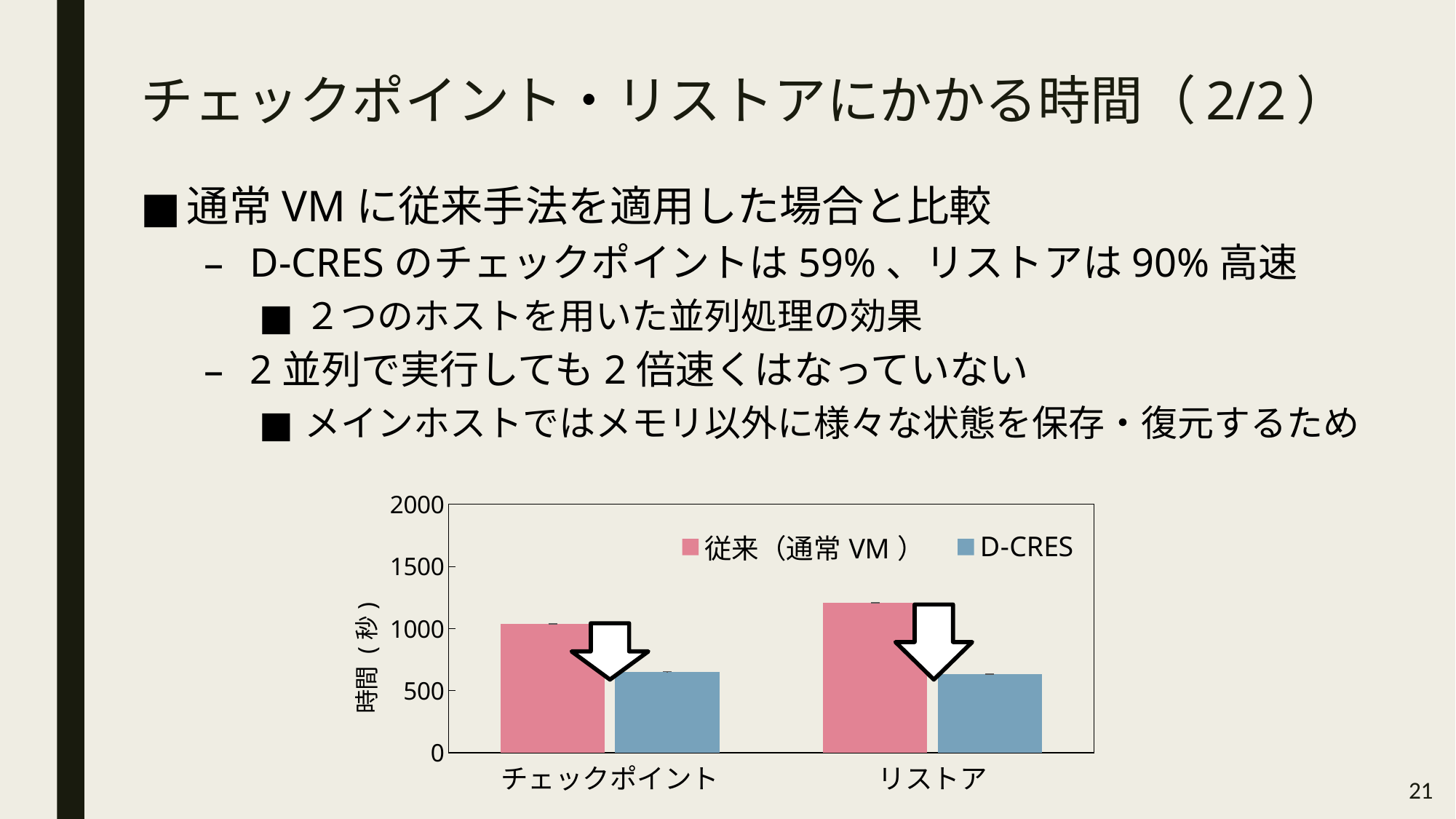
Is the value for D-CRES in リストア greater or less than 500? greater What are the two series listed in the chart's legend? 従来（通常 VM）, D-CRES What kind of chart is shown on the slide? bar chart Is the value for 従来（通常 VM） in チェックポイント greater or less than 1500? less What is the label of the chart's y axis? 時間（秒） For チェックポイント, which is larger: 従来（通常 VM） or D-CRES? 従来（通常 VM） Is the value for D-CRES in チェックポイント greater or less than 1000? less How many series does the chart's legend list? 2 For リストア, which is larger: 従来（通常 VM） or D-CRES? 従来（通常 VM） How many categories are shown on the x axis of the chart? 2 Which bar in the chart is the highest? 従来（通常 VM） for リストア